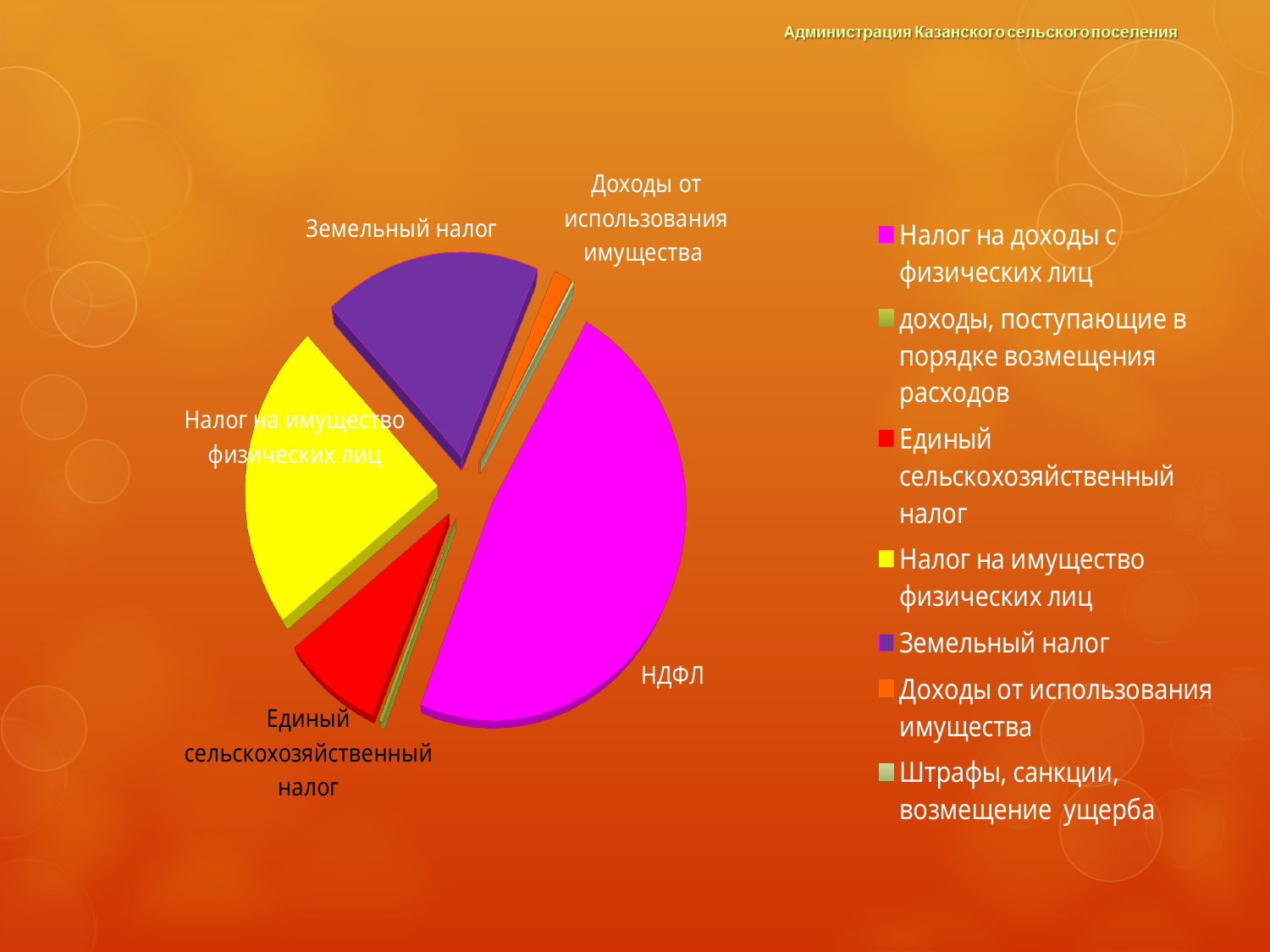
Which slice is larger: НДФЛ or Земельный налог? НДФЛ What colour is the НДФЛ slice in the pie chart? Magenta How many entries does the legend of the pie chart list? 7 Which slice is larger: Единый сельскохозяйственный налог or Доходы от использования имущества? Единый сельскохозяйственный налог What kind of chart is shown on the slide? Pie chart Which category has the largest slice in the pie chart? НДФЛ Which legend entry is shown in purple? Земельный налог Which slice is larger: Земельный налог or Единый сельскохозяйственный налог? Земельный налог